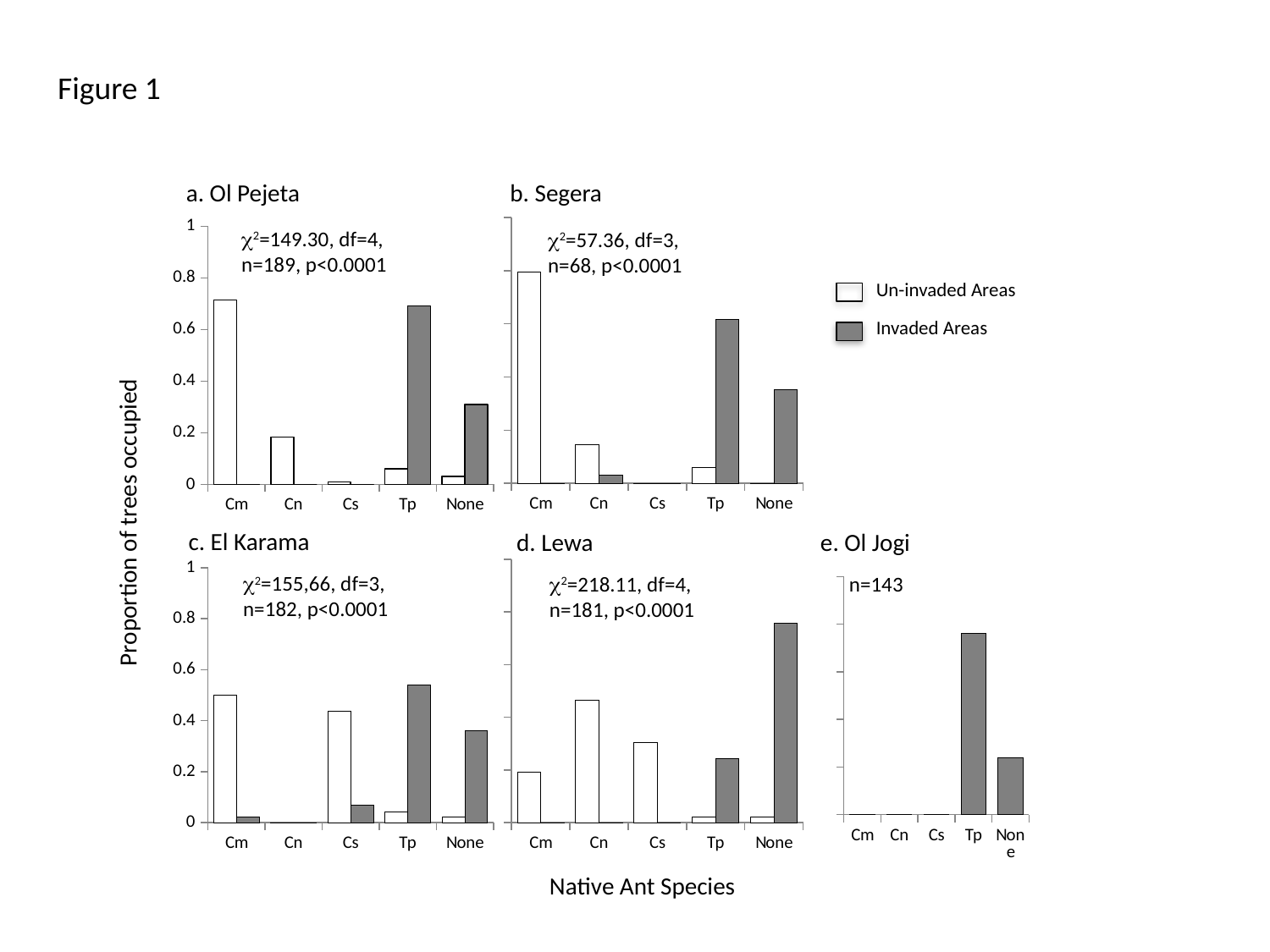
In the a. Ol Pejeta chart, which category has the highest Un-invaded Areas value? Cm In the c. El Karama chart, is the Invaded Areas value for Tp greater or less than 0.4? greater In the a. Ol Pejeta chart, is the Invaded Areas value for Tp greater or less than 0.6? greater In the b. Segera chart, is the Un-invaded Areas value for Cm greater or less than 0.6? greater How many series does the legend list? 2 In the c. El Karama chart, which is larger for Un-invaded Areas: Cm or Cs? Cm In the b. Segera chart, which category has the highest Invaded Areas value? Tp In the a. Ol Pejeta chart, how many native ant species categories are shown on the x axis? 5 What kind of chart is used in panel a. Ol Pejeta? bar chart What sample size n is printed on the e. Ol Jogi chart? n=143 In the d. Lewa chart, which category has the highest Invaded Areas value? None